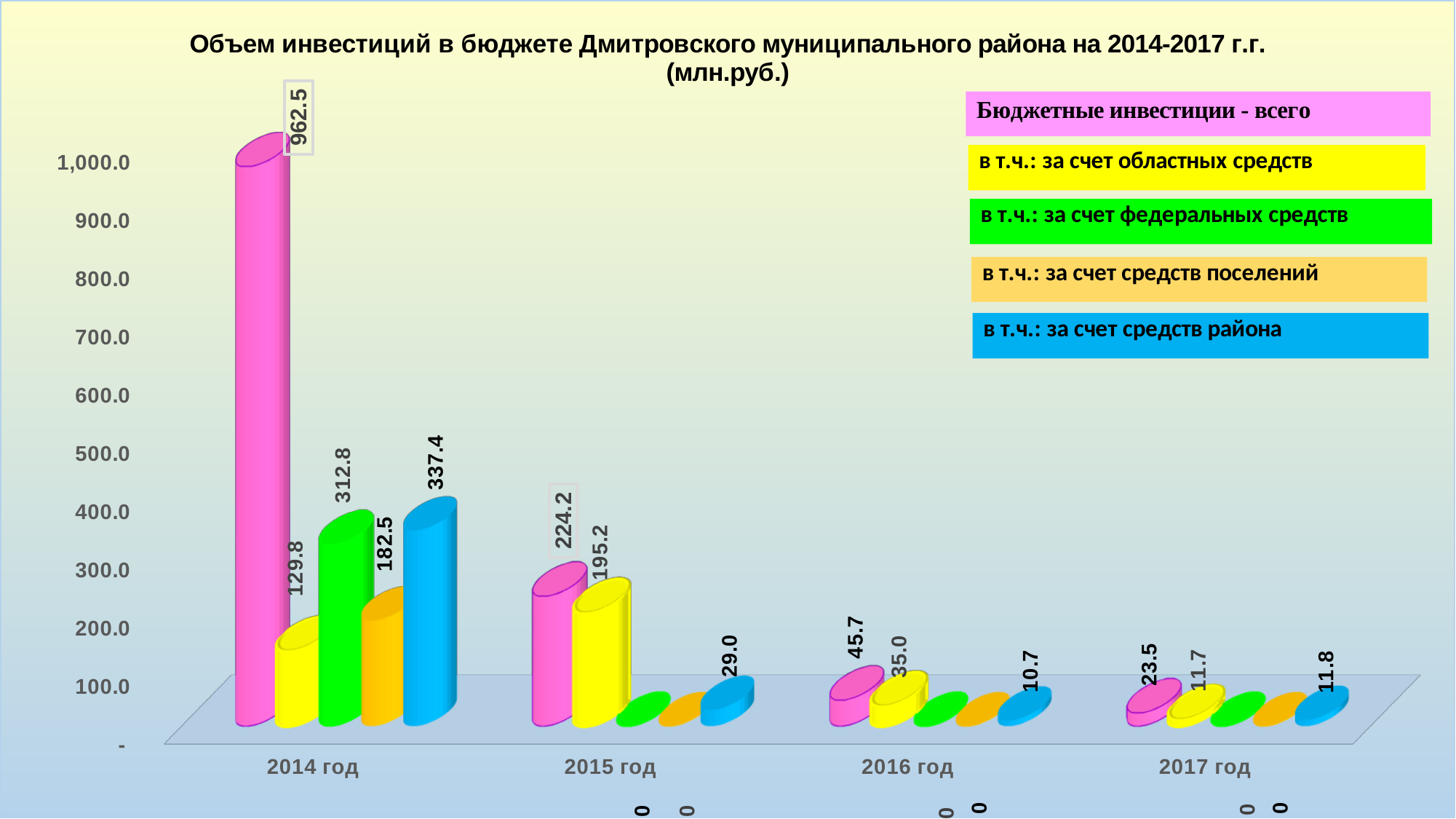
Which year has the lowest value for 'Бюджетные инвестиции - всего'? 2017 год What is the value of 'Бюджетные инвестиции - всего' for 2014 год? 962.5 Which year has the highest value for 'Бюджетные инвестиции - всего'? 2014 год What kind of chart is shown on the slide? Bar chart What is the value of 'в т.ч.: за счет средств района' for 2016 год? 10.7 What is the value of 'в т.ч.: за счет федеральных средств' for 2014 год? 312.8 What is the value of 'в т.ч.: за счет областных средств' for 2015 год? 195.2 What is the difference between 'Бюджетные инвестиции - всего' for 2014 год and 2015 год? 738.3 How many series does the legend list? 5 How many years are shown on the x axis? 4 Does the value of 'Бюджетные инвестиции - всего' rise or fall from 2014 год to 2017 год? Fall Which is larger in 2014 год: 'в т.ч.: за счет средств района' or 'в т.ч.: за счет федеральных средств'? в т.ч.: за счет средств района